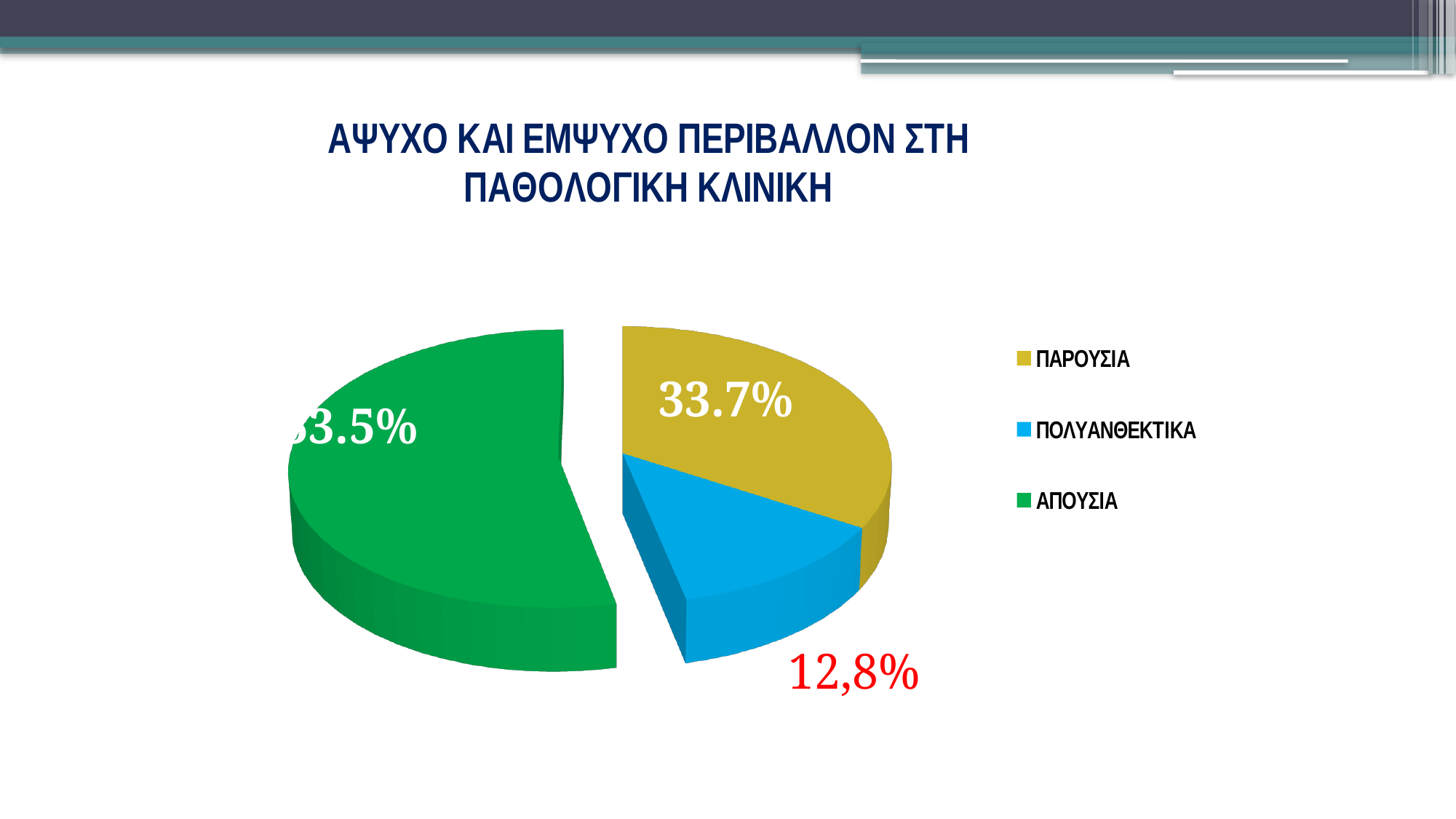
What is the title of the slide above the chart? ΑΨΥΧΟ ΚΑΙ ΕΜΨΥΧΟ ΠΕΡΙΒΑΛΛΟΝ ΣΤΗ ΠΑΘΟΛΟΓΙΚΗ ΚΛΙΝΙΚΗ How many entries does the legend list? 3 Which slice is larger, ΠΑΡΟΥΣΙΑ or ΠΟΛΥΑΝΘΕΚΤΙΚΑ? ΠΑΡΟΥΣΙΑ What percentage is shown for the ΠΑΡΟΥΣΙΑ slice? 33.7% What is the difference in percentage points between the ΠΑΡΟΥΣΙΑ slice and the ΠΟΛΥΑΝΘΕΚΤΙΚΑ slice? 20.9 How many slices does the pie chart have? 3 Which category has the largest slice of the pie? ΑΠΟΥΣΙΑ Which category has the smallest slice of the pie? ΠΟΛΥΑΝΘΕΚΤΙΚΑ What kind of chart is shown on the slide? pie chart What colour is the ΑΠΟΥΣΙΑ slice? green What percentage is shown for the ΠΟΛΥΑΝΘΕΚΤΙΚΑ slice? 12,8% Is the share of the ΑΠΟΥΣΙΑ slice greater or less than 50%? greater